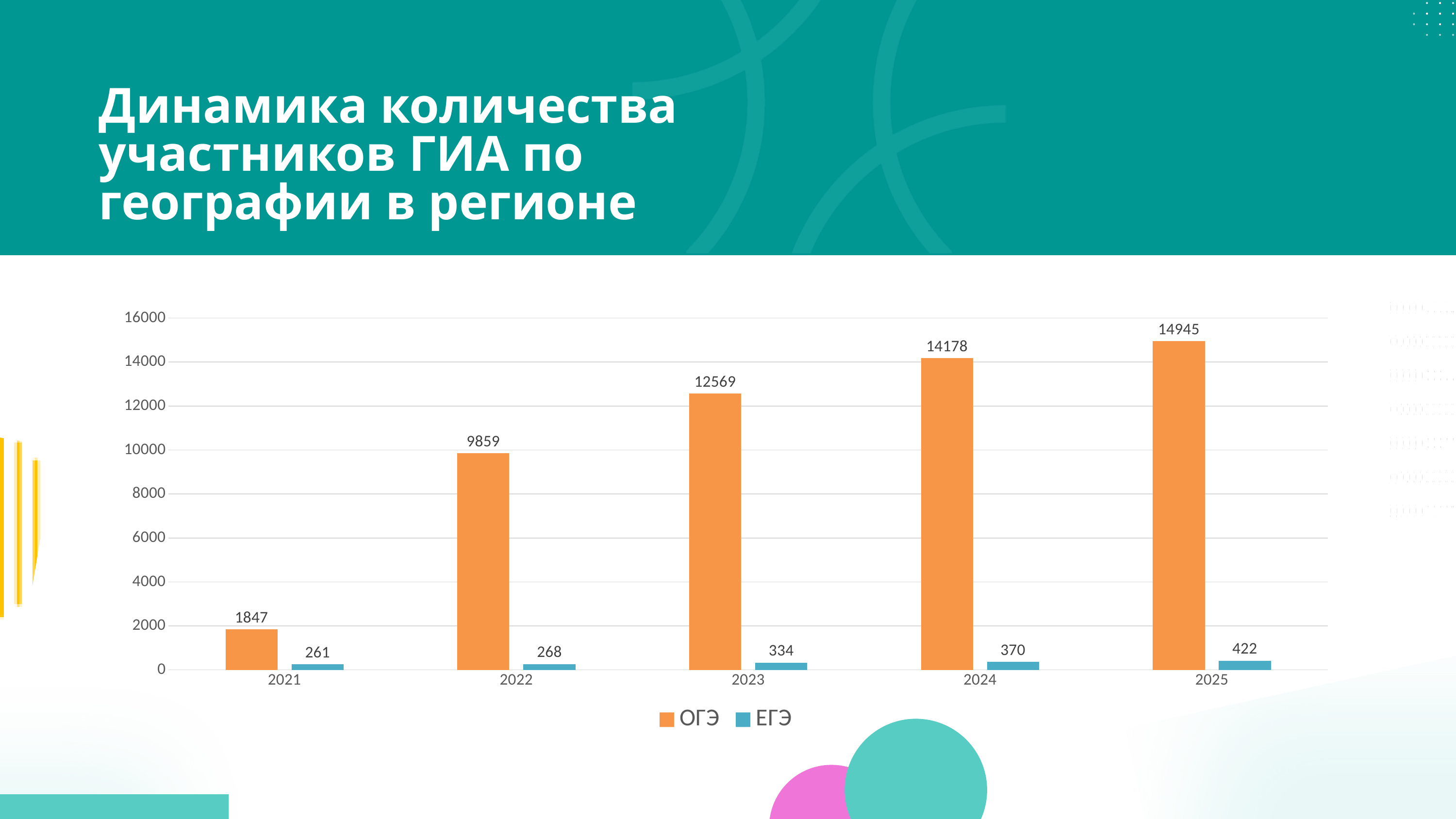
Which year has the highest ОГЭ value? 2025 What is the ОГЭ value for 2023? 12569 How many series does the legend list? 2 Which is larger, the ОГЭ value for 2022 or the ОГЭ value for 2023? 2023 Which year has the lowest ЕГЭ value? 2021 What is the difference between the ОГЭ values for 2025 and 2024? 767 What is the difference between the ЕГЭ values for 2024 and 2023? 36 Do the ОГЭ values rise or fall from 2021 to 2025? rise What is the ЕГЭ value for 2025? 422 What is the ЕГЭ value for 2021? 261 Is the ОГЭ value for 2022 greater or less than 8000? greater How many years are shown on the x axis? 5